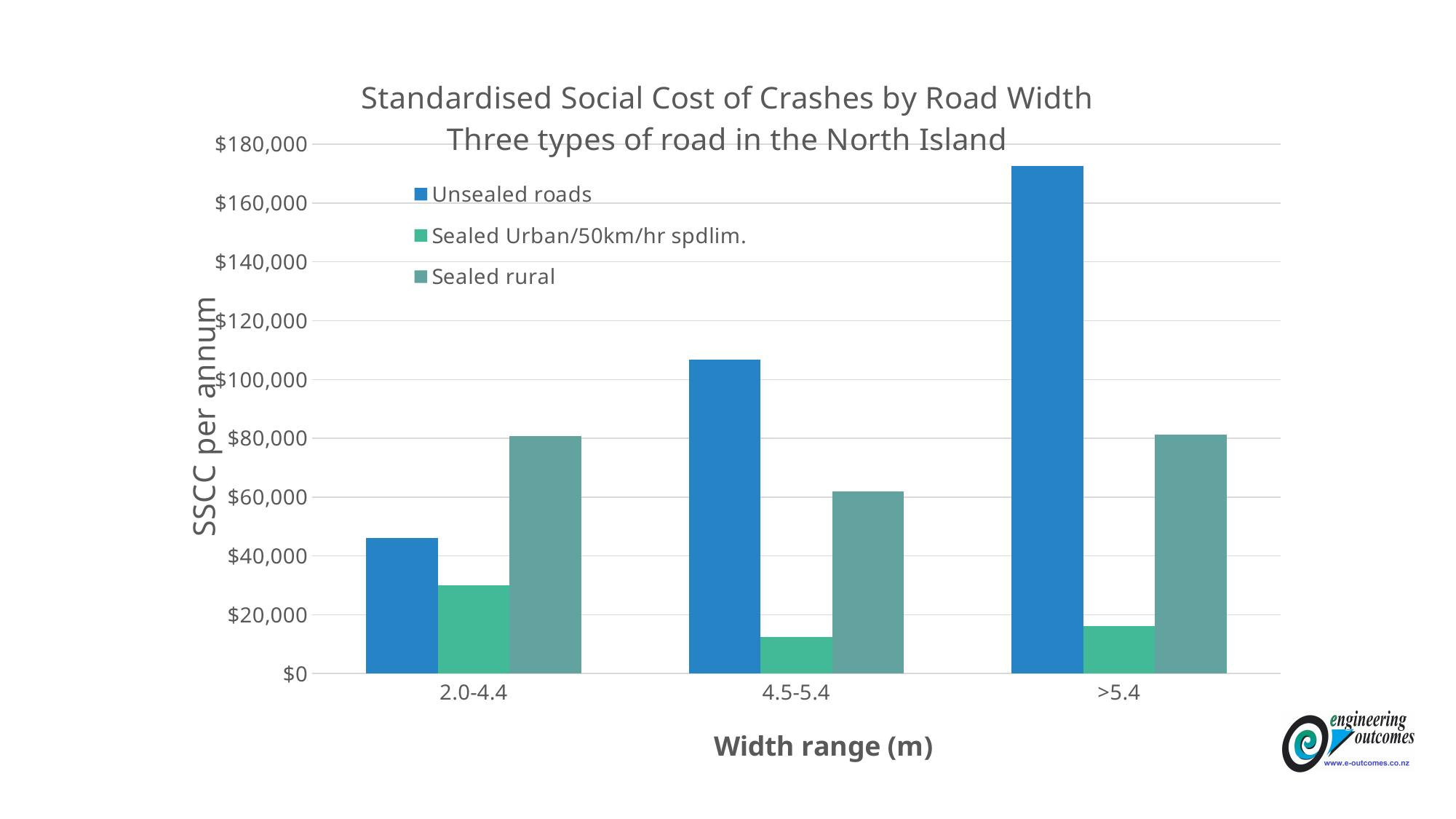
Is the value for Sealed rural in the 4.5-5.4 width range greater or less than $40,000? greater Which width range has the highest value for Unsealed roads? >5.4 What kind of chart is shown on the slide? Bar chart Do the values for Unsealed roads rise or fall as the width range increases along the x axis? rise How many width range categories are shown on the x axis? 3 Is the value for Unsealed roads in the >5.4 width range greater or less than $160,000? greater Is the value for Unsealed roads in the 4.5-5.4 width range greater or less than $100,000? greater In the 2.0-4.4 width range, which is larger: Unsealed roads or Sealed rural? Sealed rural Which width range has the lowest value for Sealed Urban/50km/hr spdlim.? 4.5-5.4 What is the label of the y axis? SSCC per annum How many series does the legend list? 3